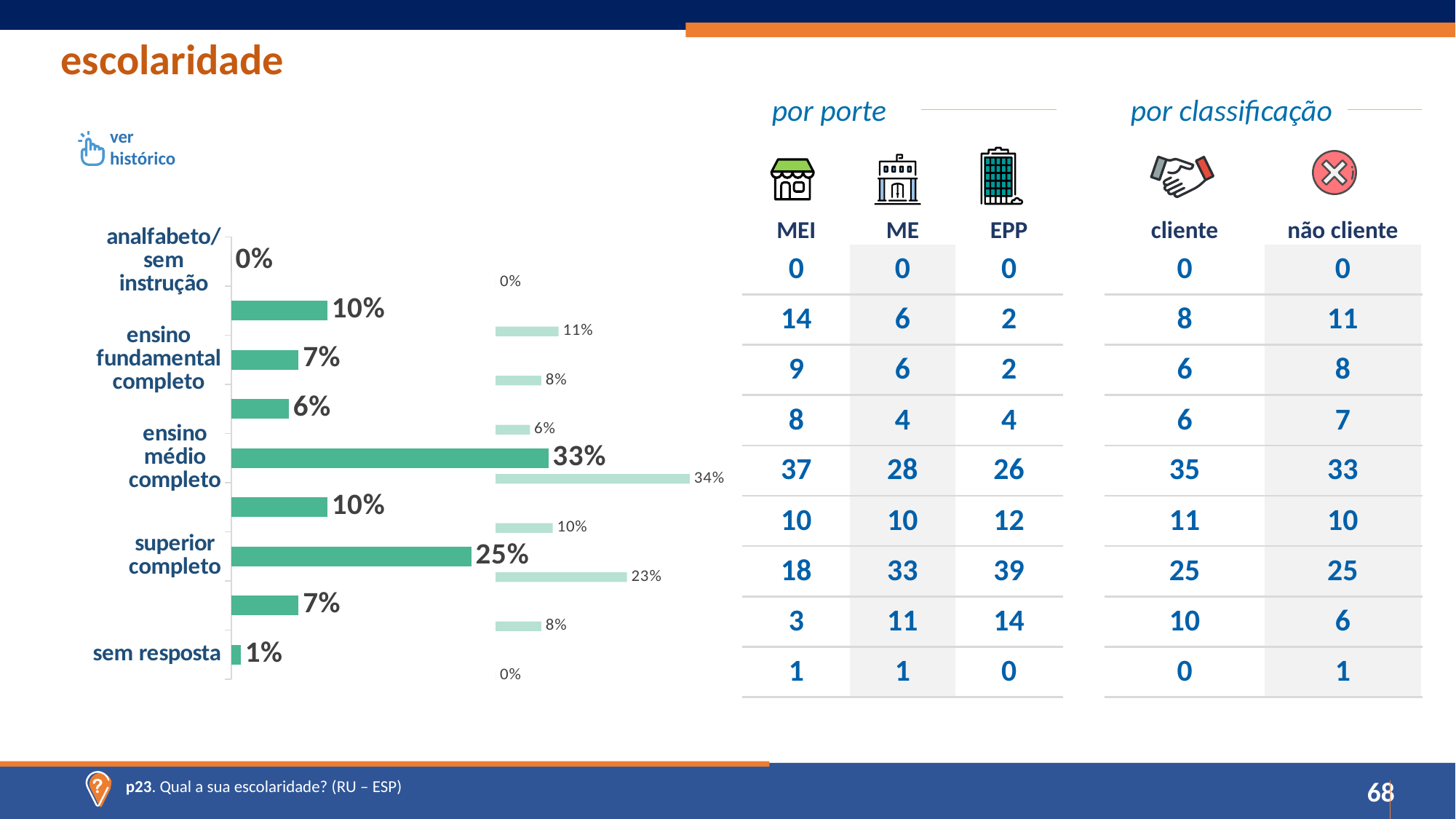
Which labeled category has the highest dark green bar? ensino médio completo What is the value of the light green bar for 'ensino médio completo'? 34% How many dark green bars are plotted in the chart? 9 What is the value of the dark green bar for 'sem resposta'? 1% What is the value of the dark green bar for 'ensino fundamental completo'? 7% Which has a larger dark green value: 'superior completo' or 'ensino fundamental completo'? superior completo What type of chart is shown on the slide? bar chart What is the title of the slide containing the chart? escolaridade What is the difference between the dark green values for 'ensino médio completo' and 'superior completo'? 8 percentage points What is the value of the light green bar for 'superior completo'? 23% What is the value of the dark green bar for 'superior completo'? 25% What is the value of the dark green bar for 'ensino médio completo'? 33%